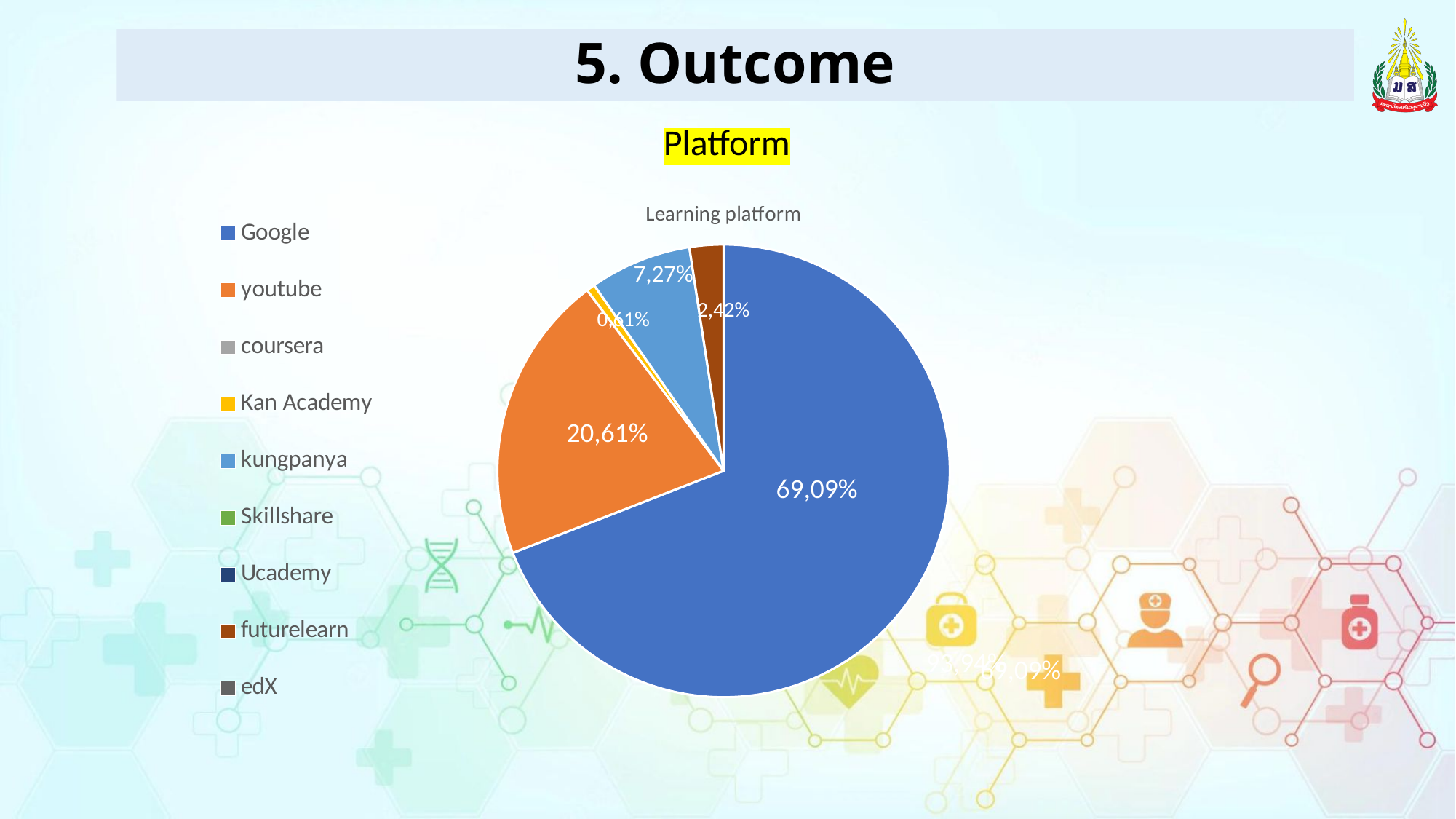
What is the difference between the kungpanya share and the futurelearn share? 4,85% What share of the pie does Kan Academy have? 0,61% Which is larger, the share for youtube or the share for kungpanya? youtube What is the title of the chart? Learning platform What share of the pie does youtube have? 20,61% What share of the pie does kungpanya have? 7,27% How many platforms does the legend list? 9 What share of the pie does futurelearn have? 2,42% What kind of chart is shown on the slide? pie chart What is the difference between the Google share and the youtube share? 48,48% What share of the pie does Google have? 69,09% Which platform has the largest slice of the pie? Google